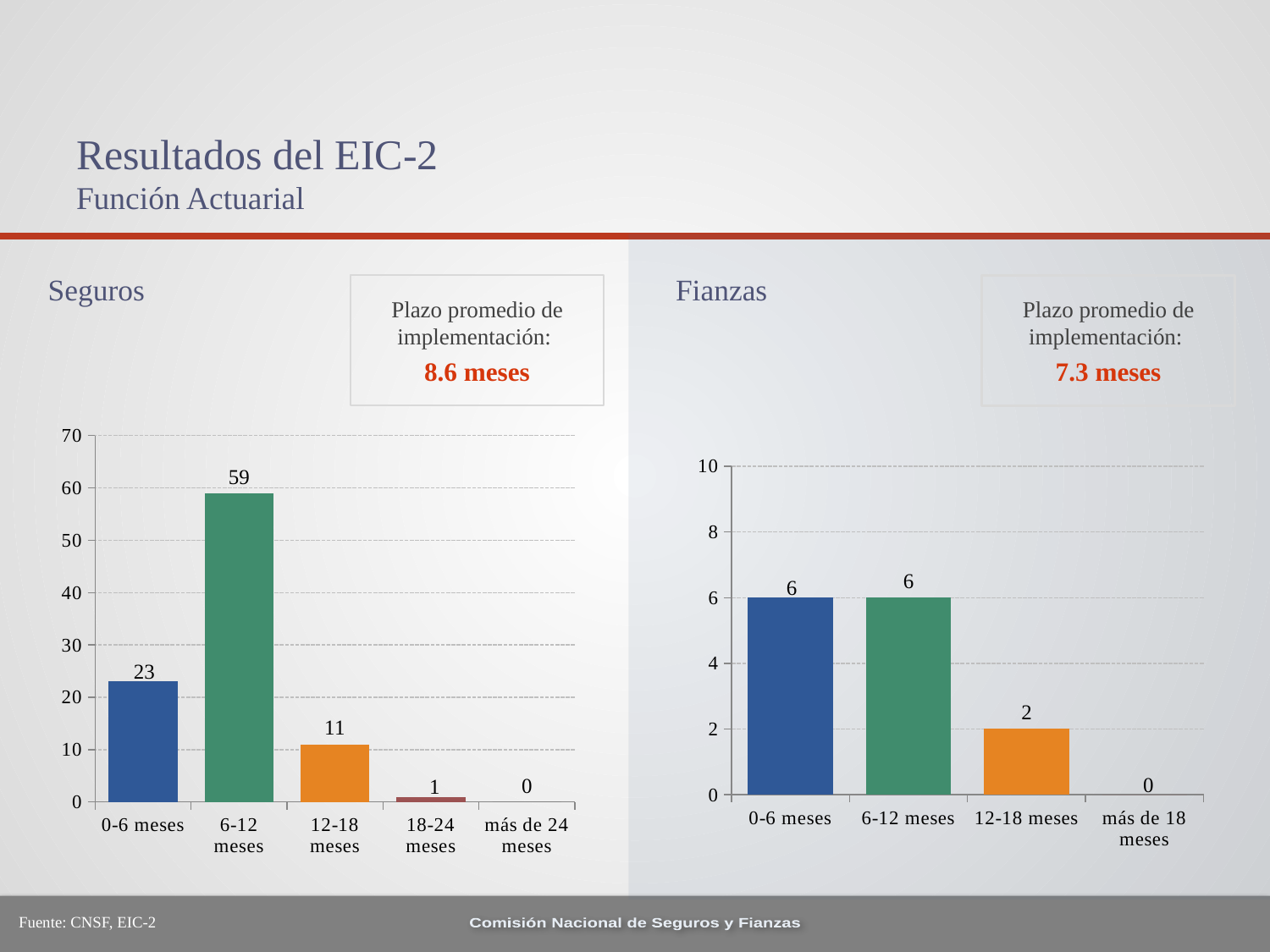
In the Fianzas chart, what is the value for más de 18 meses? 0 In the Fianzas chart, what is the value for 12-18 meses? 2 In the Seguros chart, what is the value for 0-6 meses? 23 What kind of chart is the Seguros chart? Bar chart In the Seguros chart, what is the value for 6-12 meses? 59 In the Fianzas chart, how many categories are shown on the x axis? 4 In the Seguros chart, what is the difference between the values for 6-12 meses and 0-6 meses? 36 In the Fianzas chart, which is larger, the value for 0-6 meses or the value for 12-18 meses? 0-6 meses In the Seguros chart, do the values rise or fall from 6-12 meses to más de 24 meses? Fall In the Seguros chart, how many categories are shown on the x axis? 5 In the Seguros chart, which category has the lowest value? más de 24 meses In the Seguros chart, which category has the highest value? 6-12 meses